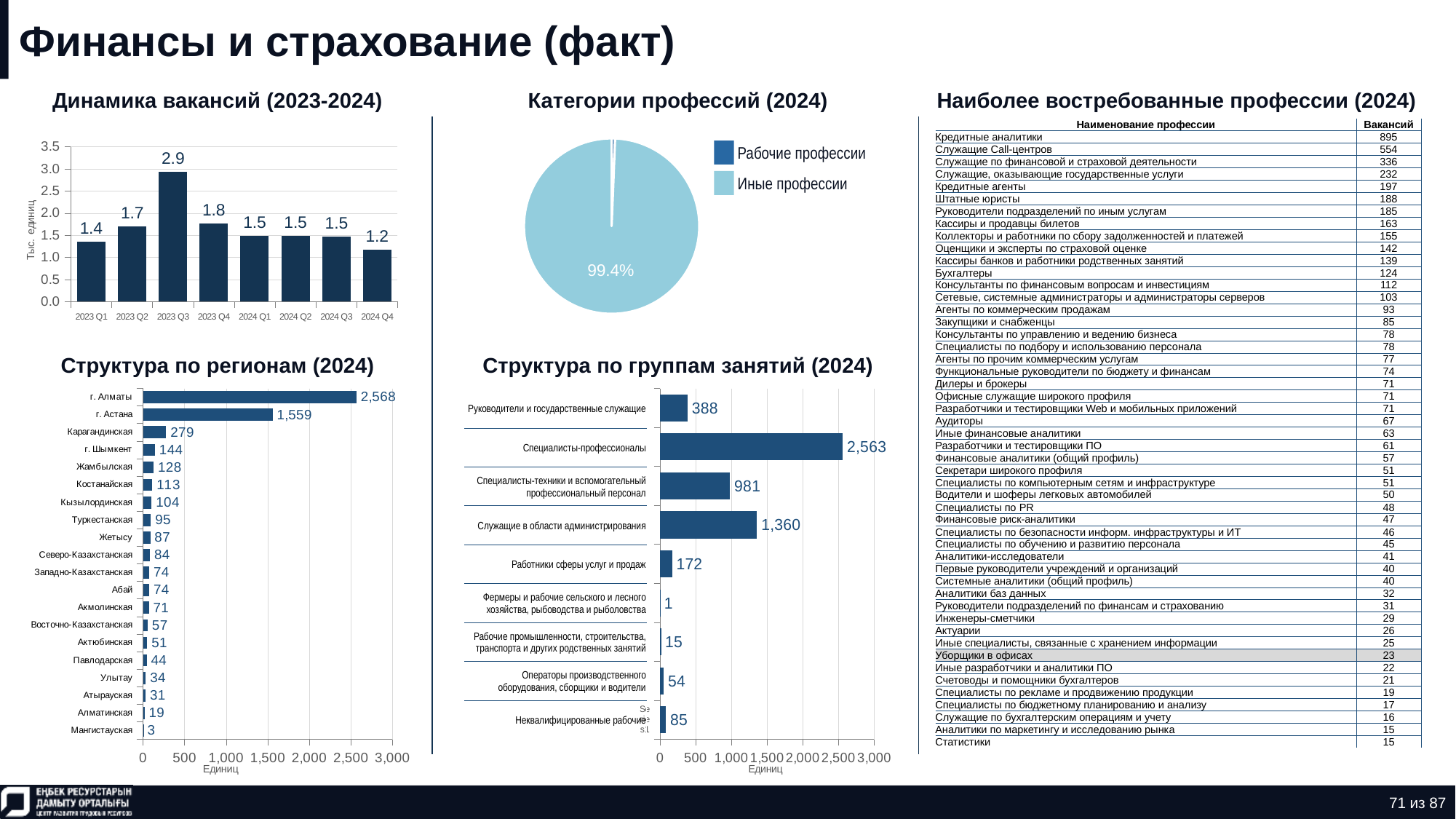
In the 'Категории профессий (2024)' chart, how many entries does the legend list? 2 In the 'Структура по группам занятий (2024)' chart, what is the value for 'Служащие в области администрирования'? 1,360 In the 'Структура по регионам (2024)' chart, how many regions are plotted? 20 In the 'Категории профессий (2024)' pie chart, what share does 'Иные профессии' have? 99.4% In the 'Динамика вакансий (2023-2024)' chart, what is the value for 2023 Q3? 2.9 In the 'Динамика вакансий (2023-2024)' chart, which quarter has the lowest value? 2024 Q4 In the 'Структура по регионам (2024)' chart, which region has the lowest value? Мангистауская In the 'Динамика вакансий (2023-2024)' chart, which quarter has the highest value? 2023 Q3 In the 'Структура по группам занятий (2024)' chart, which is larger: 'Специалисты-техники и вспомогательный профессиональный персонал' or 'Служащие в области администрирования'? Служащие в области администрирования In the 'Динамика вакансий (2023-2024)' chart, what is the difference between the values for 2023 Q3 and 2024 Q4? 1.7 In the 'Структура по регионам (2024)' chart, what is the value for г. Астана? 1,559 In the 'Динамика вакансий (2023-2024)' chart, how many quarters are plotted? 8